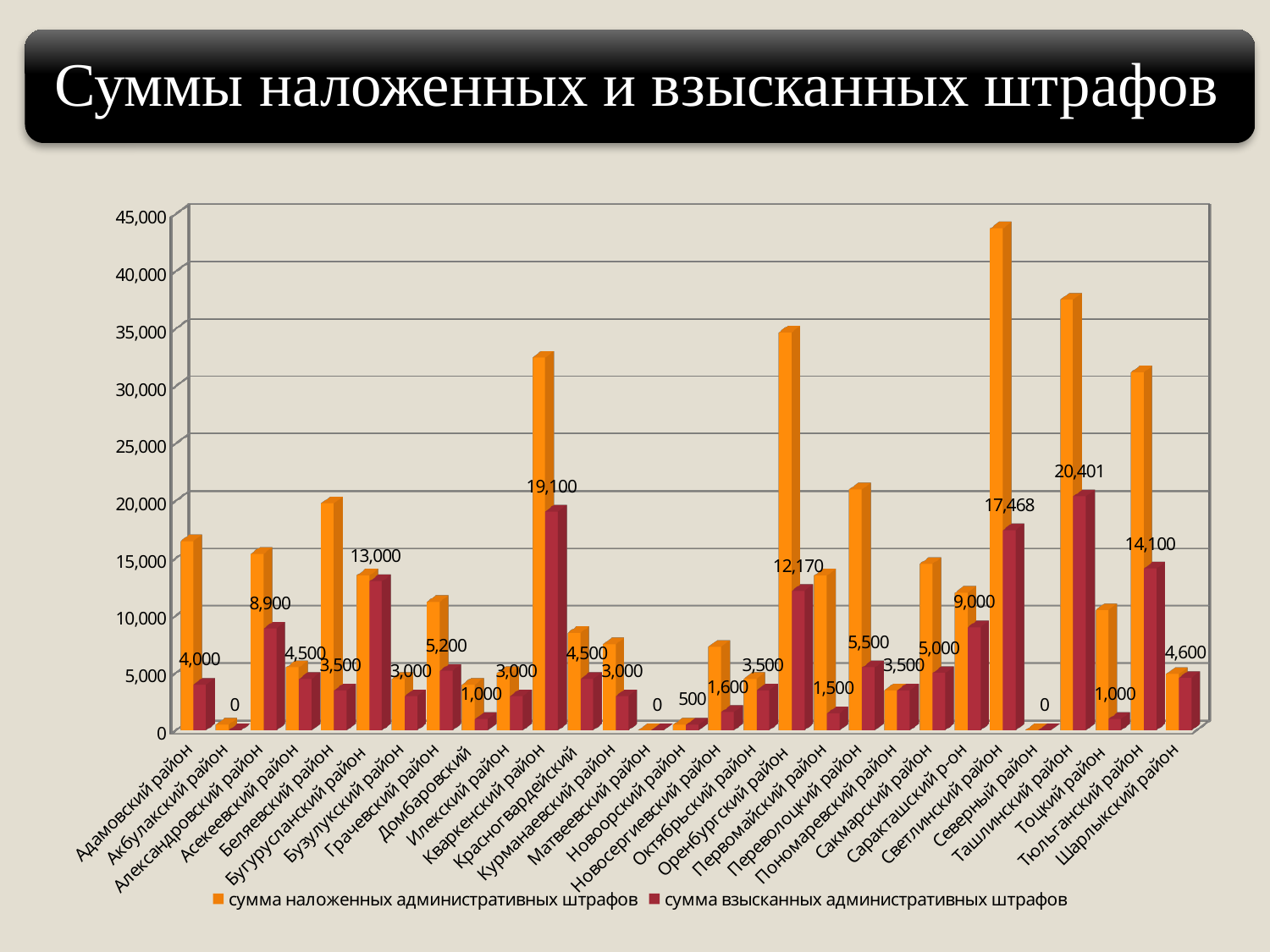
What is the value of сумма взысканных административных штрафов for Оренбургский район? 12,170 What is the value of сумма взысканных административных штрафов for Светлинский район? 17,468 Is the value of сумма наложенных административных штрафов for Светлинский район greater or less than 40,000? greater What is the value of сумма взысканных административных штрафов for Кваркенский район? 19,100 What is the difference between сумма взысканных административных штрафов for Кваркенский район and Бугурусланский район? 6,100 What type of chart is shown on the slide? Bar chart Is the value of сумма наложенных административных штрафов for Оренбургский район greater or less than 30,000? greater How many series does the legend list? 2 Which has the larger сумма взысканных административных штрафов: Кваркенский район or Тюльганский район? Кваркенский район What is the difference between сумма взысканных административных штрафов for Ташлинский район and Светлинский район? 2,933 Which district has the highest value of сумма наложенных административных штрафов? Светлинский район Which district has the highest value of сумма взысканных административных штрафов? Ташлинский район